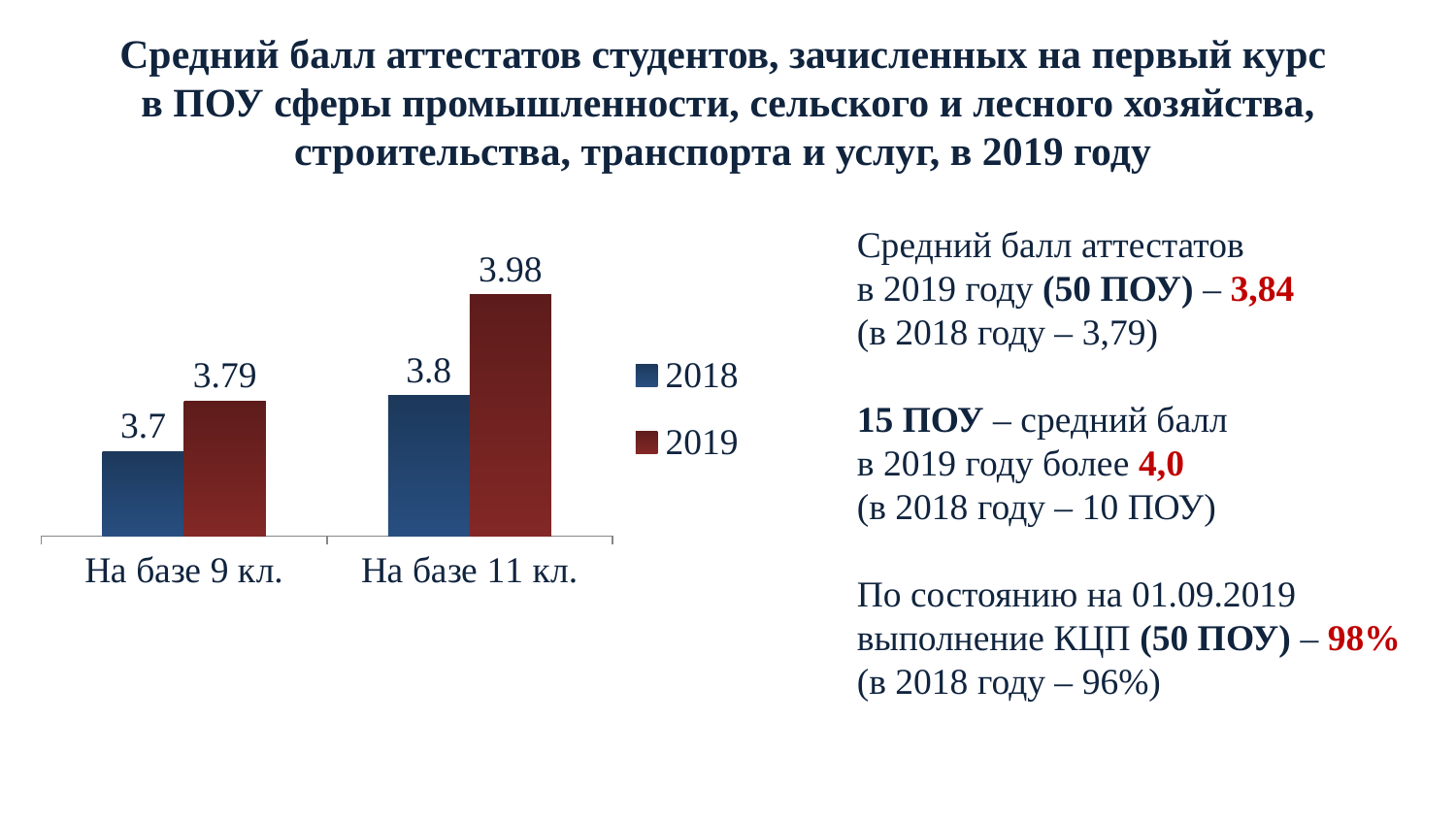
What is the value for 2018 in the category "На базе 11 кл."? 3.8 What is the difference between the 2019 and 2018 values in the category "На базе 11 кл."? 0.18 What is the value for 2018 in the category "На базе 9 кл."? 3.7 How many categories are shown on the x axis of the chart? 2 What is the difference between the 2019 and 2018 values in the category "На базе 9 кл."? 0.09 What is the value for 2019 in the category "На базе 11 кл."? 3.98 What is the value for 2019 in the category "На базе 9 кл."? 3.79 What kind of chart is shown on the slide? Bar chart Which category has the lowest value for the 2018 series? На базе 9 кл. Which category has the highest value for the 2019 series? На базе 11 кл. How many series does the legend list? 2 Which is larger: the 2019 value for "На базе 9 кл." or the 2018 value for "На базе 11 кл."? 2018 value for На базе 11 кл.